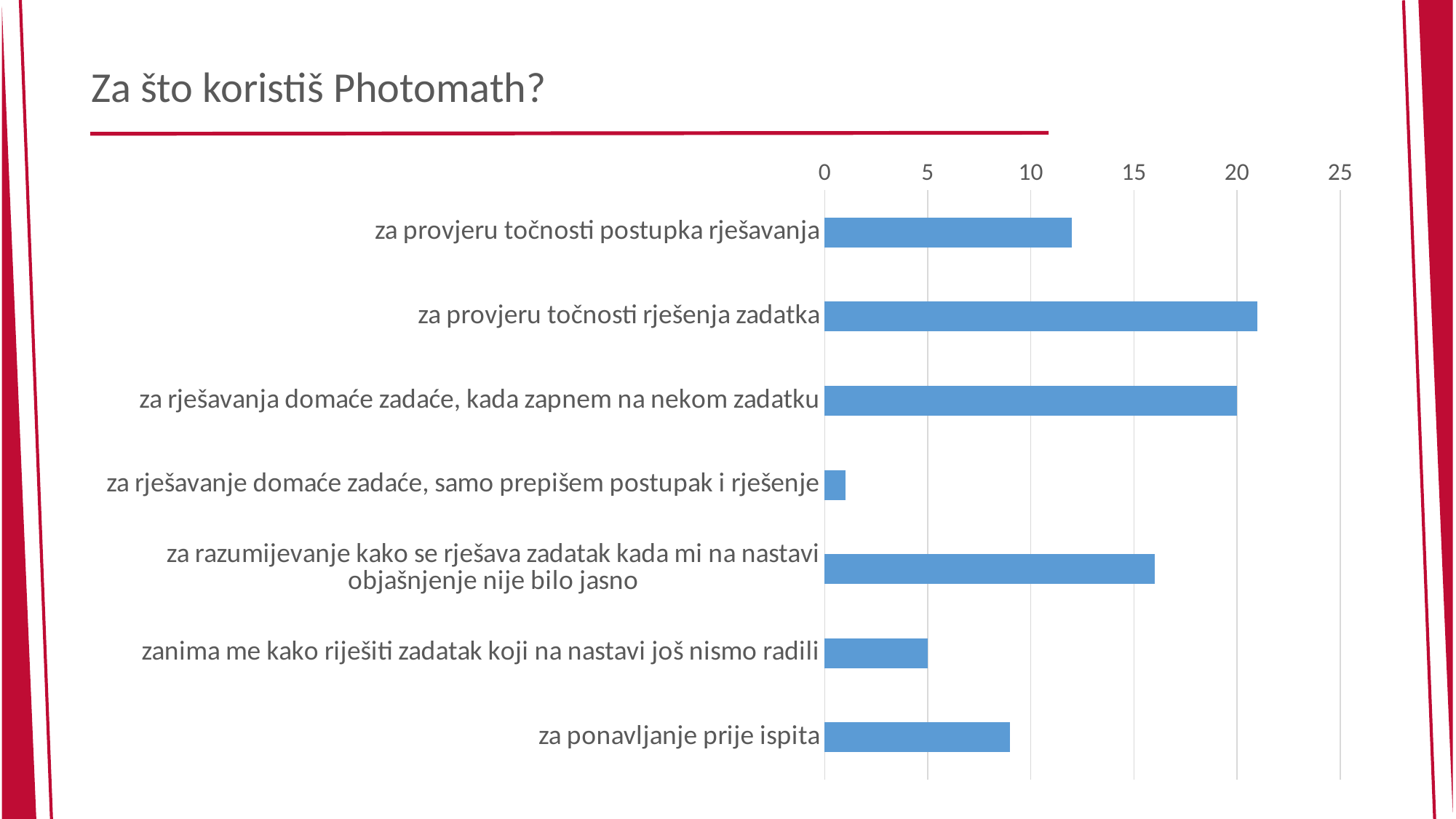
What is the value for "zanima me kako riješiti zadatak koji na nastavi još nismo radili"? 5 Is the value for "za provjeru točnosti rješenja zadatka" greater or less than 20? greater Which is larger: the value for "za razumijevanje kako se rješava zadatak kada mi na nastavi objašnjenje nije bilo jasno" or for "za provjeru točnosti postupka rješavanja"? za razumijevanje kako se rješava zadatak kada mi na nastavi objašnjenje nije bilo jasno What is the title of the chart? Za što koristiš Photomath? Which is larger: the value for "za provjeru točnosti postupka rješavanja" or for "za ponavljanje prije ispita"? za provjeru točnosti postupka rješavanja Is the value for "za razumijevanje kako se rješava zadatak kada mi na nastavi objašnjenje nije bilo jasno" greater or less than 15? greater Is the value for "za provjeru točnosti postupka rješavanja" greater or less than 10? greater What is the value for "za rješavanja domaće zadaće, kada zapnem na nekom zadatku"? 20 Which category has the lowest value? za rješavanje domaće zadaće, samo prepišem postupak i rješenje What kind of chart is shown on the slide? bar chart How many categories are shown in the chart? 7